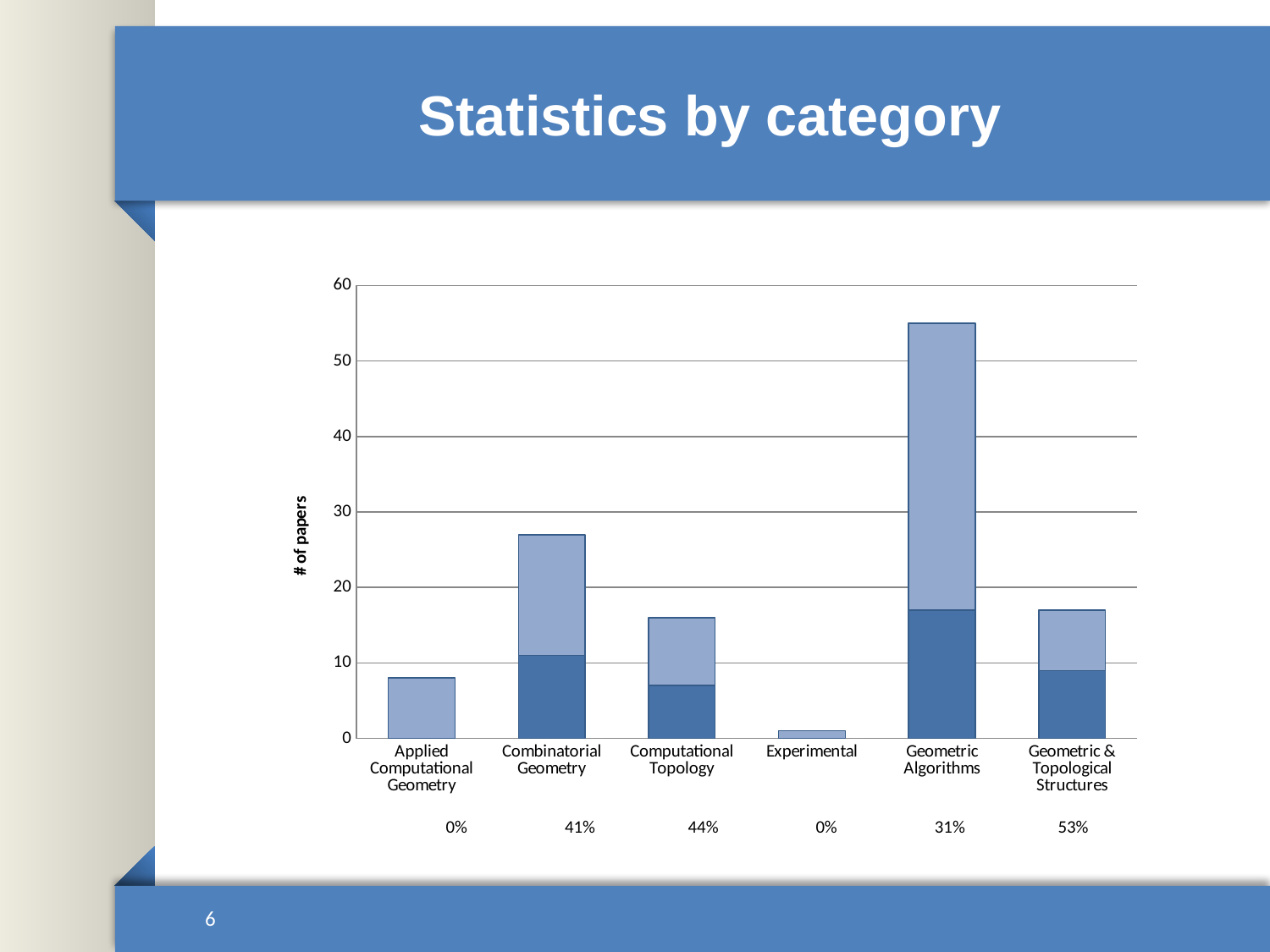
How many categories are shown along the x axis of the chart? 6 What percentage is printed below the Combinatorial Geometry category? 41% What kind of chart is shown on the slide? bar chart Is the total bar height for Geometric Algorithms greater or less than 50? greater Which category has the tallest bar (the most papers)? Geometric Algorithms Is the bar for Applied Computational Geometry greater or less than 10? less What percentage is printed below the Geometric & Topological Structures category? 53% Is the total bar height for Computational Topology greater or less than 20? less What is the label on the vertical axis of the chart? # of papers Which category has the shortest bar (the fewest papers)? Experimental Which has the taller bar: Combinatorial Geometry or Geometric & Topological Structures? Combinatorial Geometry